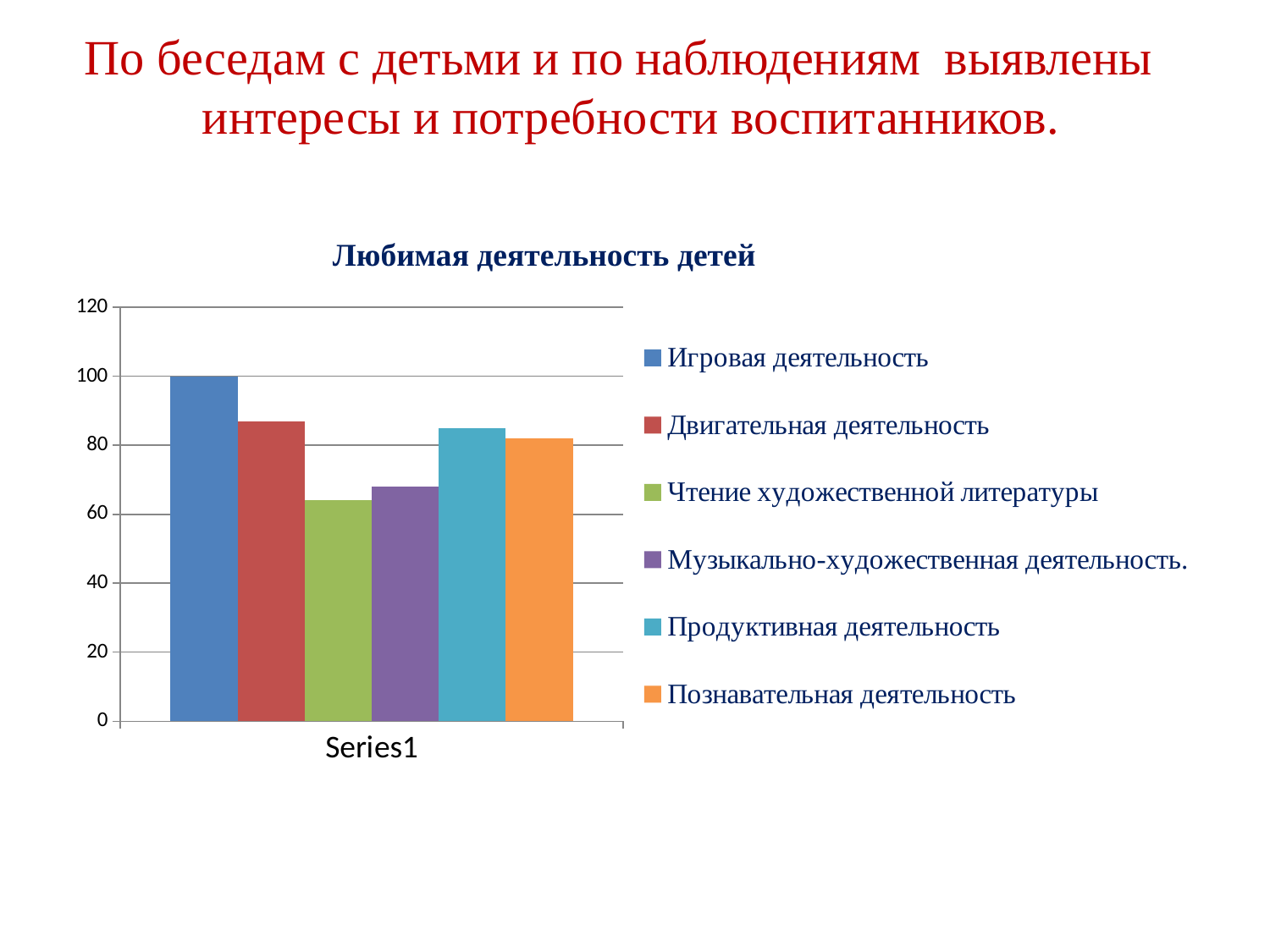
Is the value for Музыкально-художественная деятельность greater or less than 60? greater What type of chart is shown on the slide? bar chart Which activity has the lowest bar in the chart? Чтение художественной литературы Is the value for Двигательная деятельность greater or less than 80? greater What is the label of the category shown on the x axis? Series1 What is the title of the chart? Любимая деятельность детей Which activity has the highest bar in the chart? Игровая деятельность Is the value for Чтение художественной литературы greater or less than 80? less How many series does the legend list? 6 What is the value for Игровая деятельность? 100 Which is larger, the value for Игровая деятельность or the value for Познавательная деятельность? Игровая деятельность